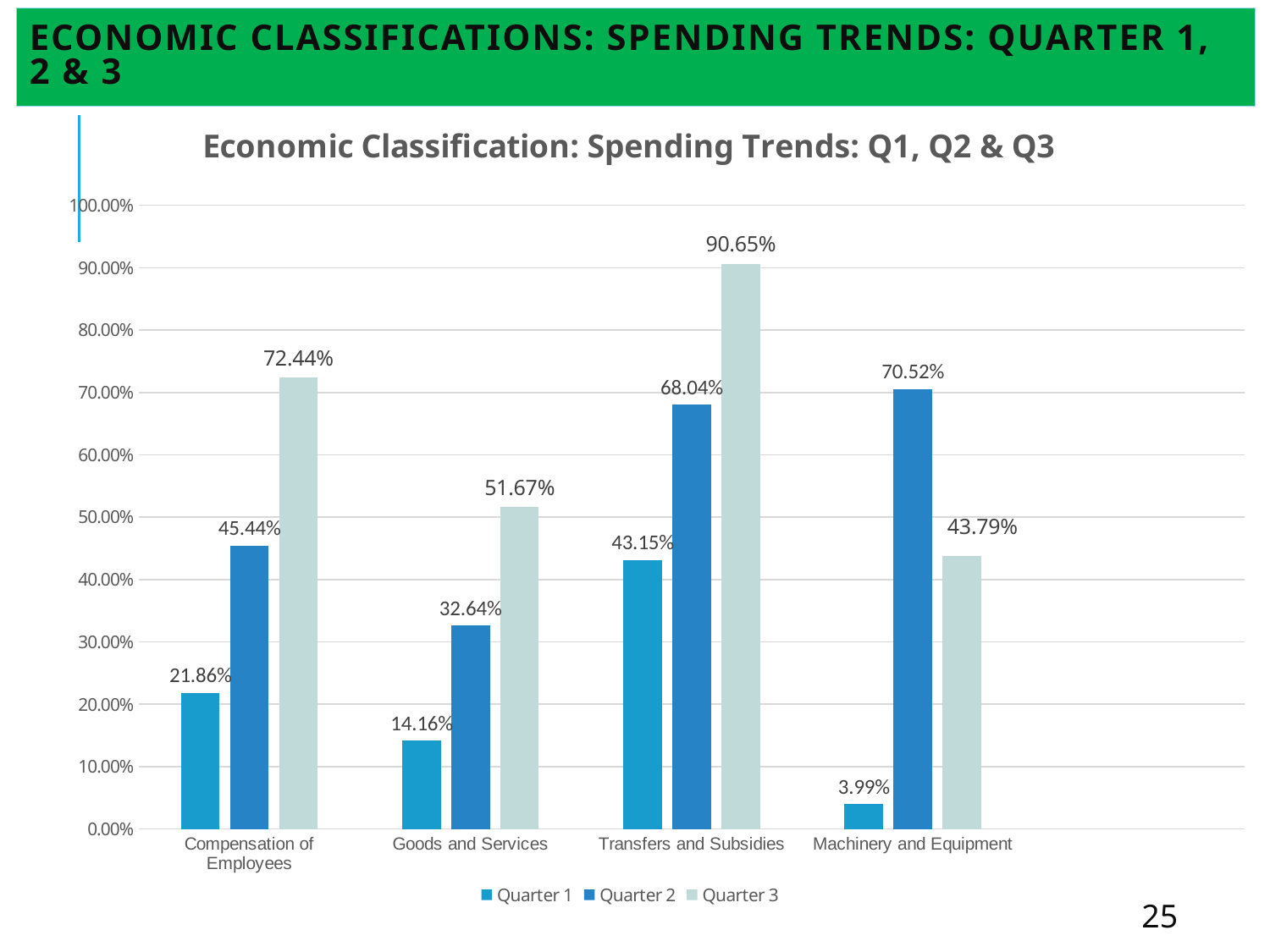
Which is larger for Machinery and Equipment: the Quarter 2 value or the Quarter 3 value? Quarter 2 Which category has the highest Quarter 1 value? Transfers and Subsidies Is the Quarter 2 value for Transfers and Subsidies greater or less than 60.00%? greater Which category has the lowest Quarter 3 value? Machinery and Equipment What is the Quarter 2 value for Goods and Services? 32.64% What kind of chart is shown on the slide? Bar chart What is the Quarter 1 value for Machinery and Equipment? 3.99% What is the title of the chart? Economic Classification: Spending Trends: Q1, Q2 & Q3 How many categories are shown on the x axis? 4 What is the Quarter 3 value for Transfers and Subsidies? 90.65% What is the difference between the Quarter 3 and Quarter 1 values for Compensation of Employees? 50.58% How many series does the legend list? 3